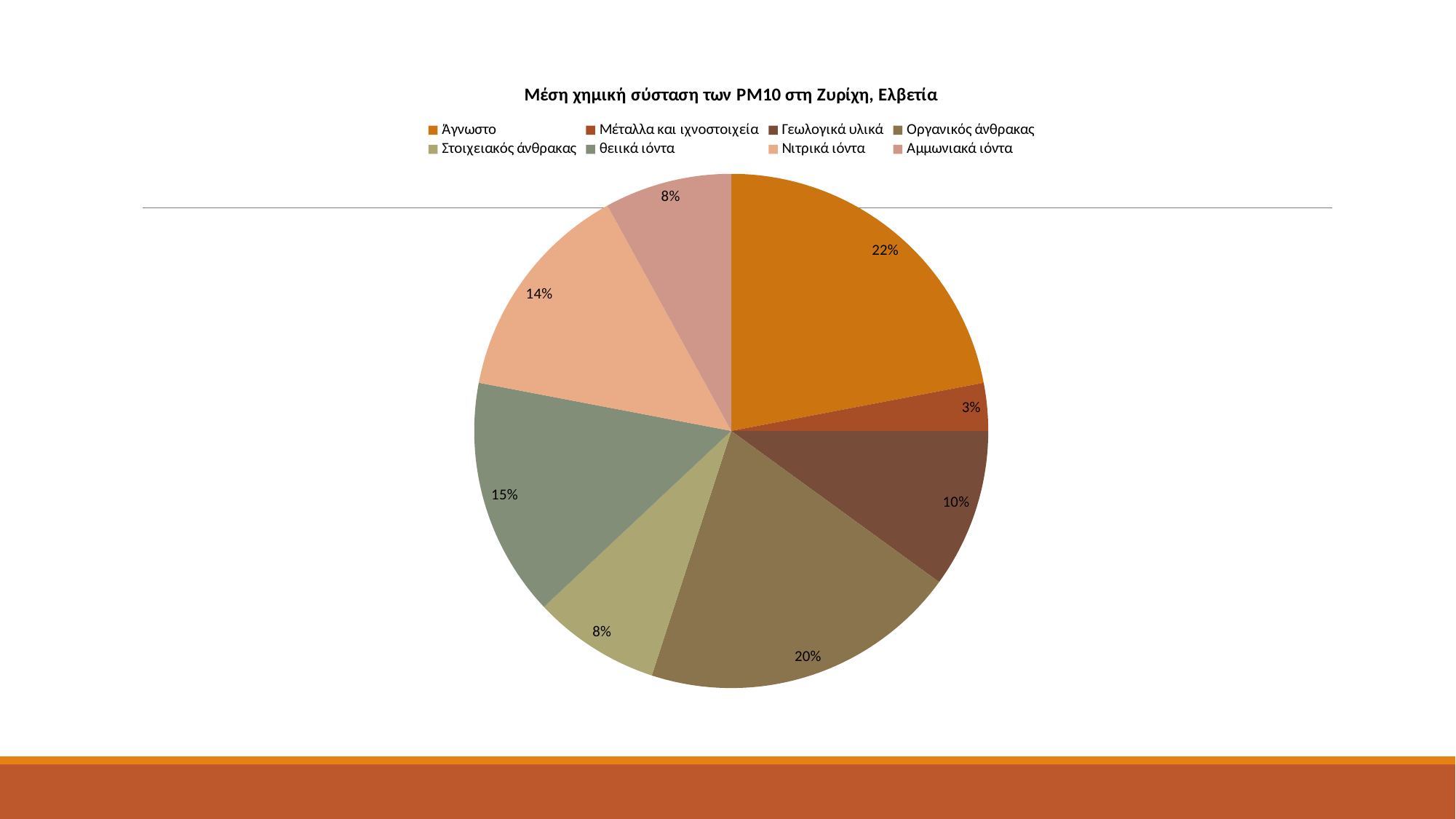
Which category has the smallest slice of the pie? Μέταλλα και ιχνοστοιχεία Which category has the largest slice of the pie? Άγνωστο What kind of chart is shown on the slide? Pie chart What is the value for Νιτρικά ιόντα? 14% Which is larger, the share of θειικά ιόντα or the share of Νιτρικά ιόντα? θειικά ιόντα What percentage is shown for θειικά ιόντα? 15% What is the difference between the shares of Άγνωστο and Γεωλογικά υλικά? 12% What is the value shown for Οργανικός άνθρακας? 20% What is the combined share of Στοιχειακός άνθρακας and Αμμωνιακά ιόντα? 16% How many categories are shown in the pie chart? 8 What share of the pie does Άγνωστο represent? 22% What is the title of the chart? Μέση χημική σύσταση των PM10 στη Ζυρίχη, Ελβετία